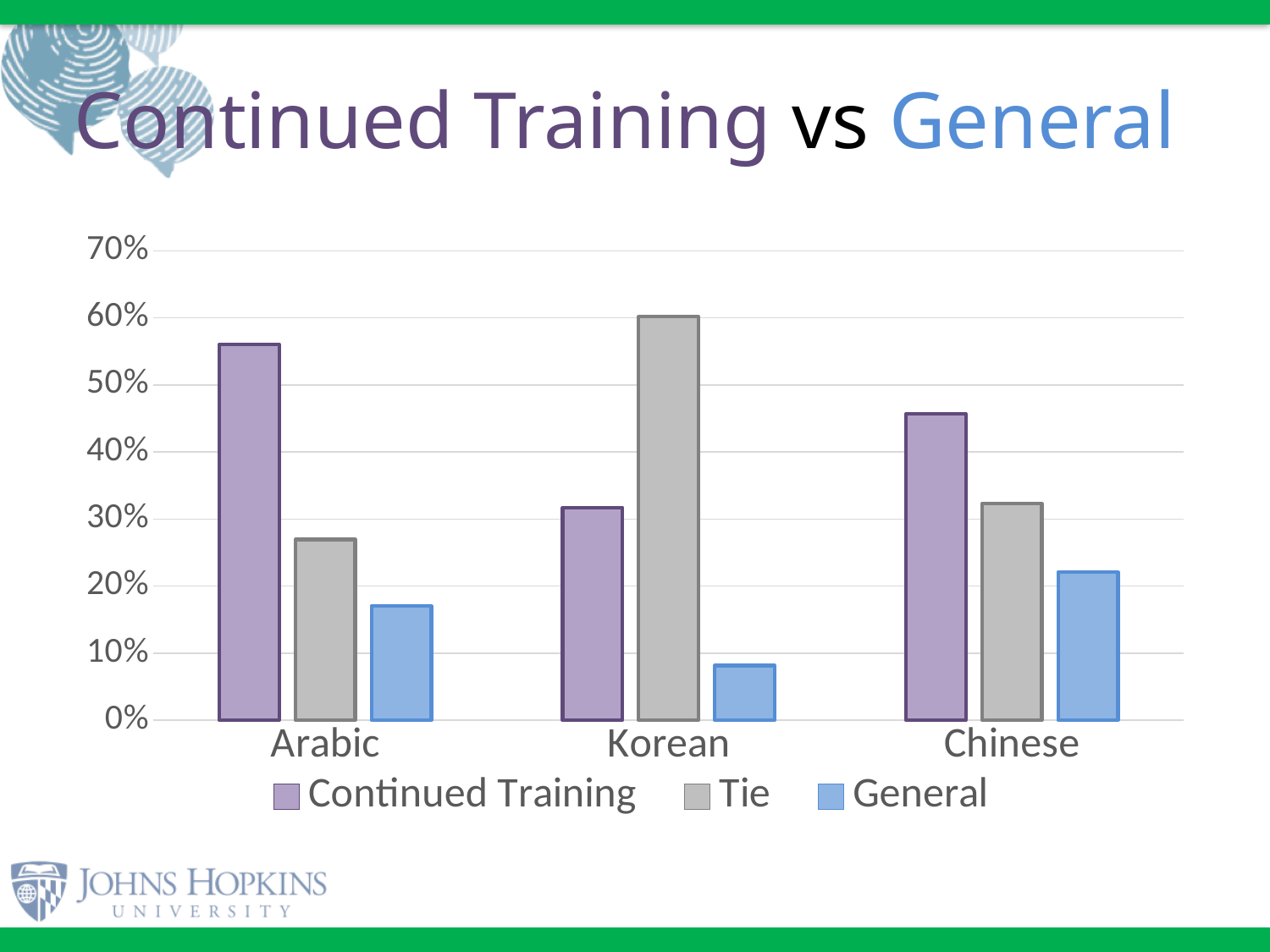
What kind of chart is shown on the slide? bar chart How many language categories are shown on the x axis? 3 Which is larger for Chinese: the Continued Training value or the Tie value? Continued Training For Korean, which series has the tallest bar? Tie Which language has the lowest General value? Korean Which language has the highest Continued Training value? Arabic Which is larger: the General value for Chinese or the General value for Arabic? Chinese What colour are the General bars in the chart? blue Is the General value for Korean greater or less than 10%? less How many series does the legend list? 3 Is the Continued Training value for Arabic greater or less than 50%? greater Is the Tie value for Korean greater or less than 50%? greater